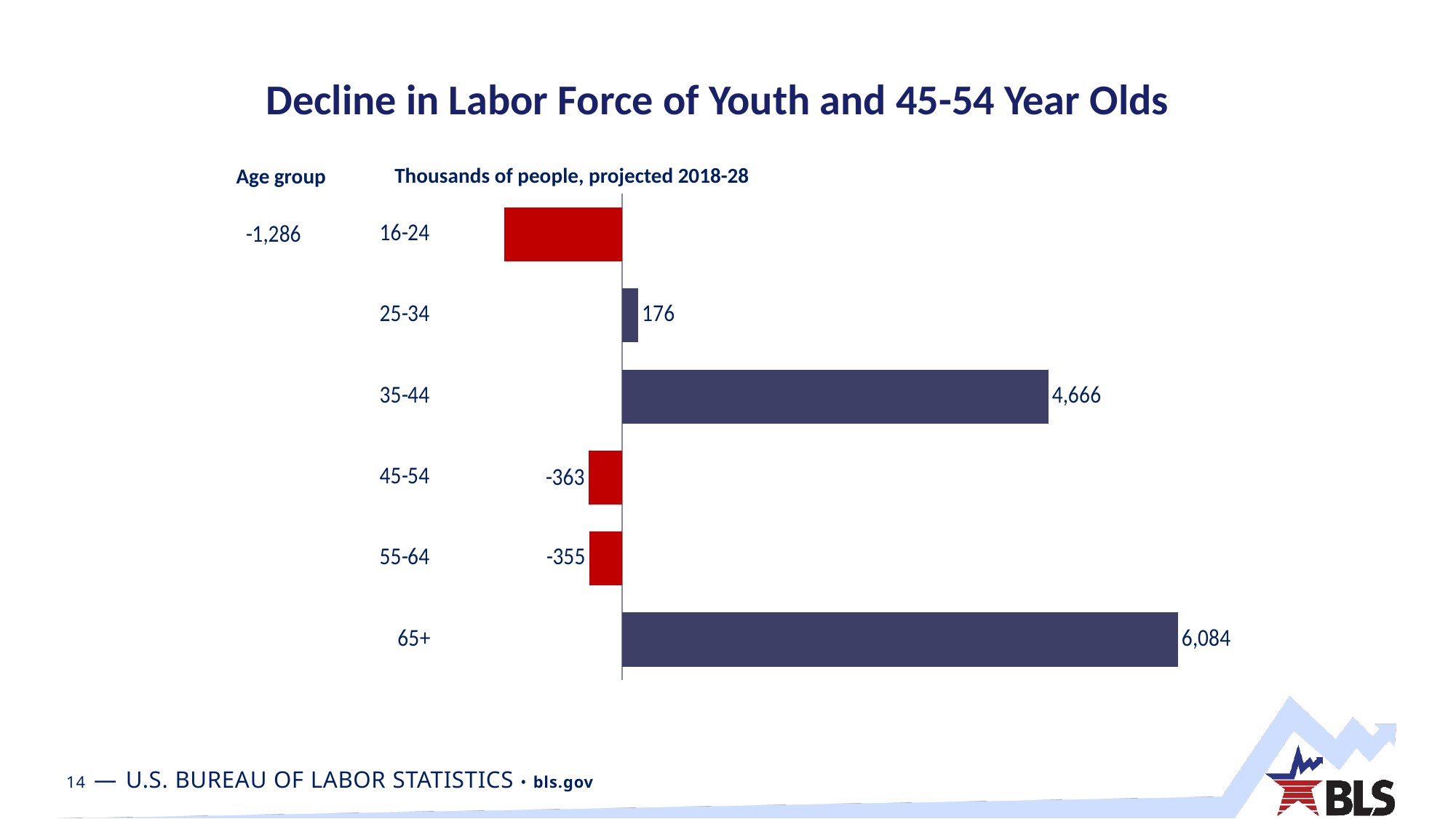
How many age groups show a projected decline (negative value)? 3 What is the projected change in labor force for the 16-24 age group? -1,286 Which age group has the largest projected increase in labor force? 65+ What is the title of the chart? Decline in Labor Force of Youth and 45-54 Year Olds Which age group has a larger projected change, 25-34 or 35-44? 35-44 What is the difference between the projected changes for the 65+ and 35-44 age groups? 1,418 What kind of chart is shown on the slide? Bar chart What is the projected change in labor force for the 45-54 age group? -363 What is the projected change in labor force for the 65+ age group? 6,084 How many age groups are shown in the chart? 6 What is the projected change in labor force for the 35-44 age group? 4,666 Which age group has the largest projected decline in labor force? 16-24